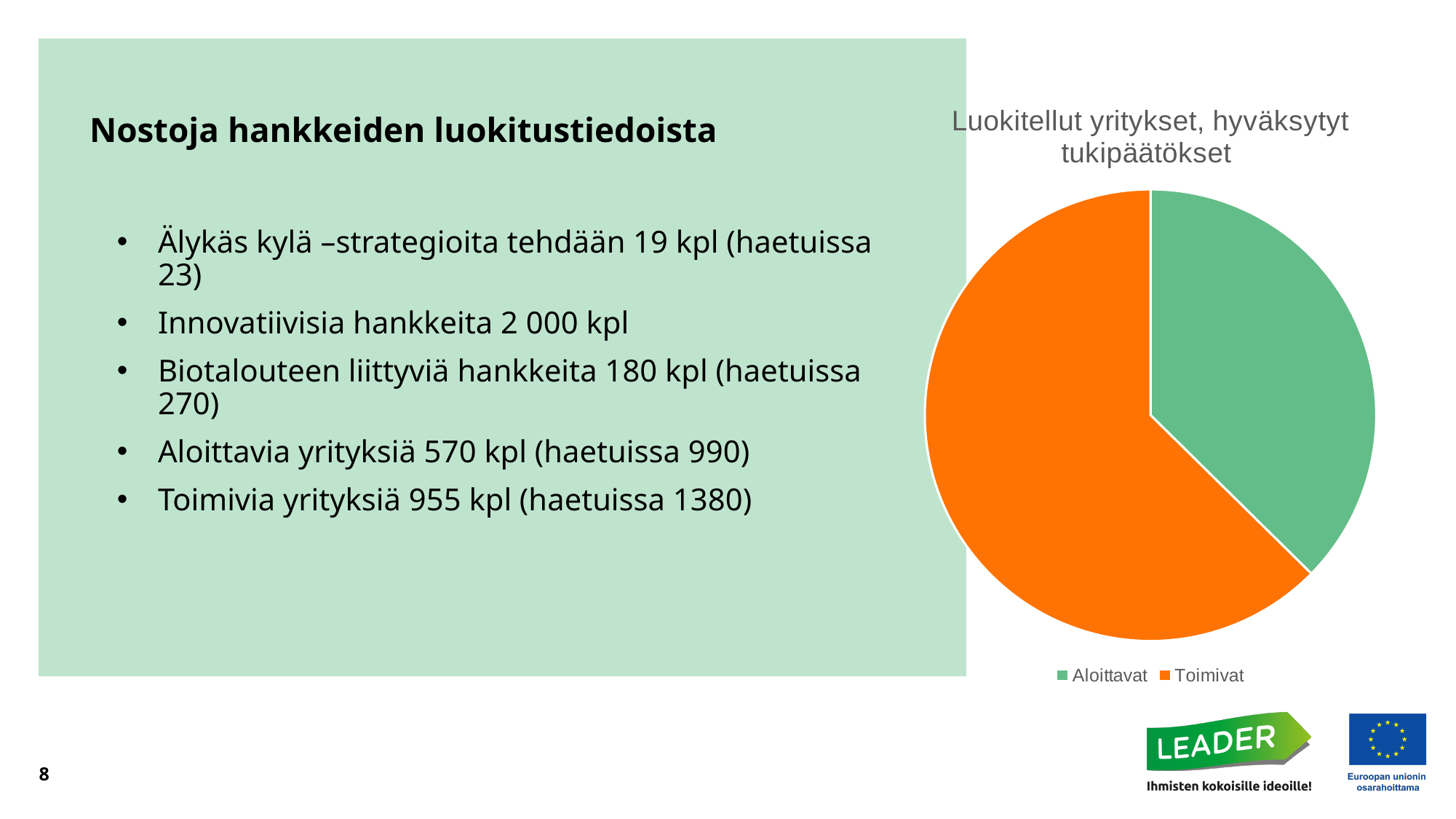
Which slice of the pie chart is the smallest? Aloittavat Does the Toimivat slice take up more or less than half of the pie chart? more How many slices does the pie chart have? 2 Which slice of the pie chart is the largest? Toimivat What is the title of the pie chart? Luokitellut yritykset, hyväksytyt tukipäätökset What colour is the Toimivat slice in the pie chart? orange How many entries does the legend of the pie chart list? 2 In the pie chart, which is larger: Aloittavat or Toimivat? Toimivat What kind of chart is shown on the slide? pie chart